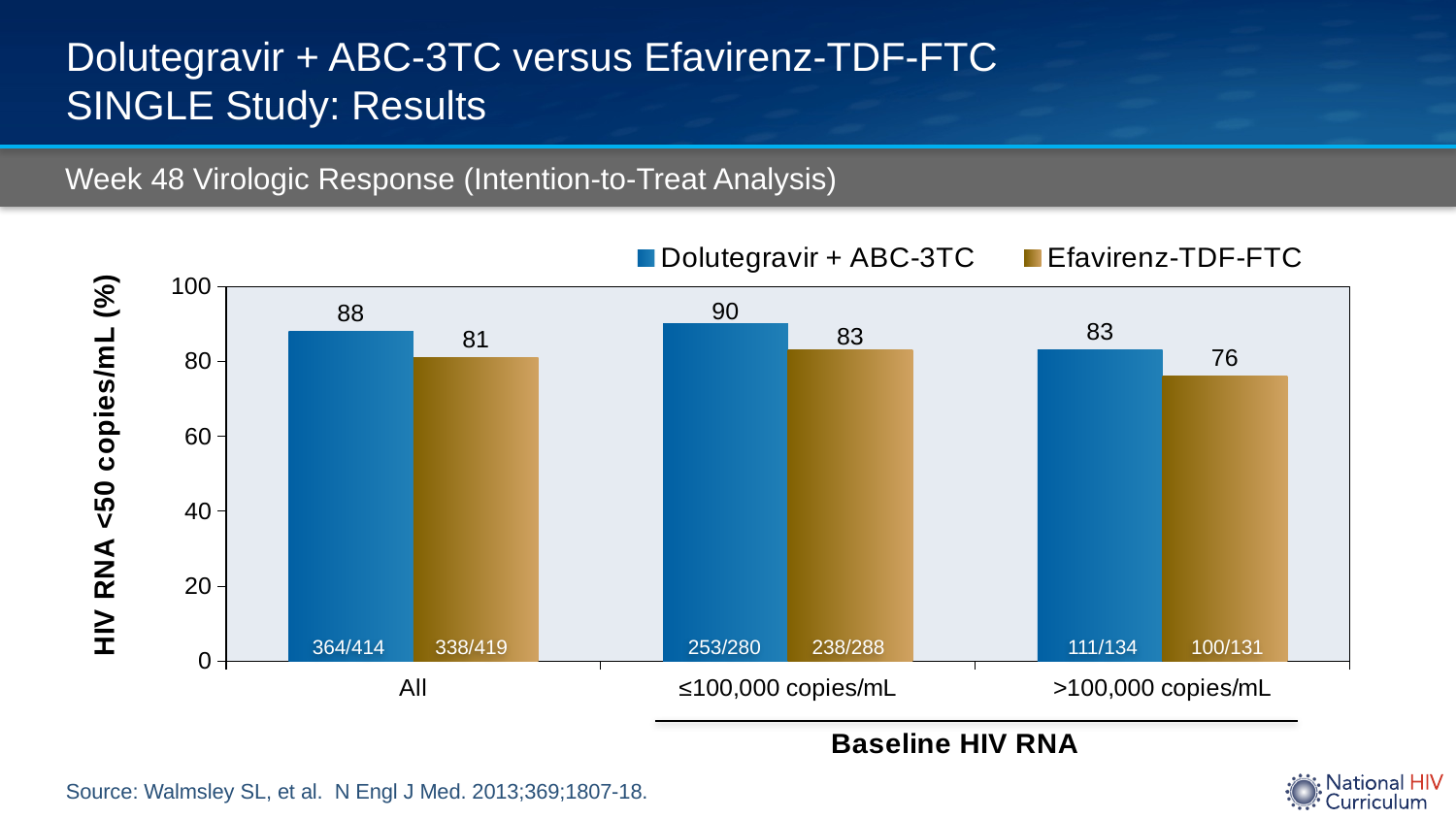
Which category has the lowest value for Efavirenz-TDF-FTC? >100,000 copies/mL What is the value for Dolutegravir + ABC-3TC in the All category? 88 What kind of chart is shown on the slide? Bar chart What is the value for Efavirenz-TDF-FTC in the ≤100,000 copies/mL category? 83 How many categories are shown on the x axis? 3 What is the difference between Dolutegravir + ABC-3TC and Efavirenz-TDF-FTC in the All category? 7 Which series has the larger value in the ≤100,000 copies/mL category? Dolutegravir + ABC-3TC What is the value for Efavirenz-TDF-FTC in the >100,000 copies/mL category? 76 Which category has the highest value for Dolutegravir + ABC-3TC? ≤100,000 copies/mL How many series does the legend list? 2 What is the y-axis label of the chart? HIV RNA <50 copies/mL (%) What is the difference between Dolutegravir + ABC-3TC and Efavirenz-TDF-FTC in the >100,000 copies/mL category? 7